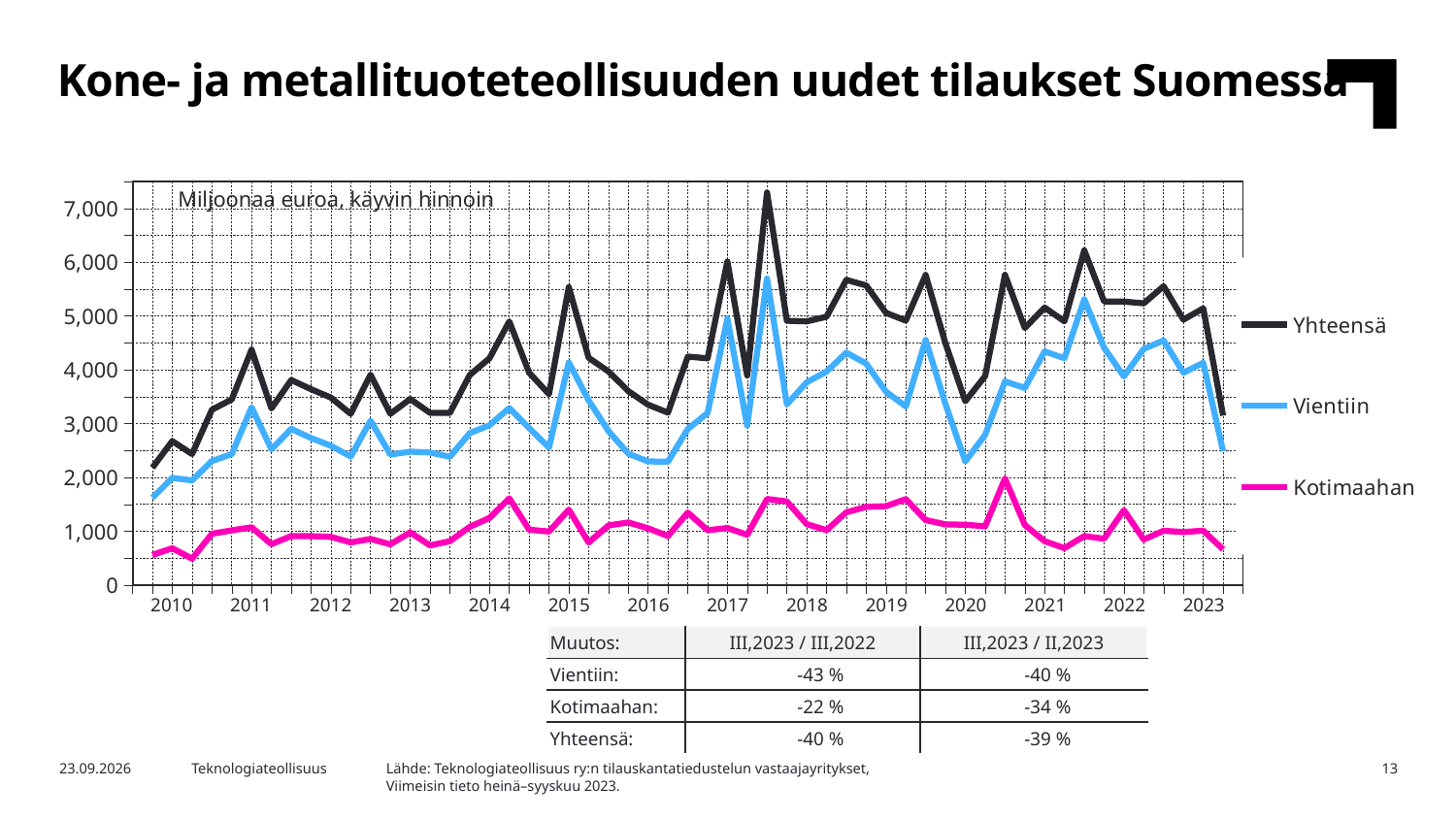
What unit is stated in the label inside the chart area? Miljoonaa euroa, käyvin hinnoin How many years are labelled on the x axis of the chart? 14 What kind of chart is shown on the slide? line chart Is the first value of the Kotimaahan line in 2010 greater or less than 1,000? less Is the highest peak of the Yhteensä line greater or less than 7,000? greater In which year does the Yhteensä line reach its highest peak? 2017 Which series has the highest values throughout the chart? Yhteensä What are the three series named in the chart legend? Yhteensä, Vientiin, Kotimaahan Is the highest peak of the Vientiin line greater or less than 5,000? greater Which series has the lowest values throughout the chart? Kotimaahan How many series does the chart legend list? 3